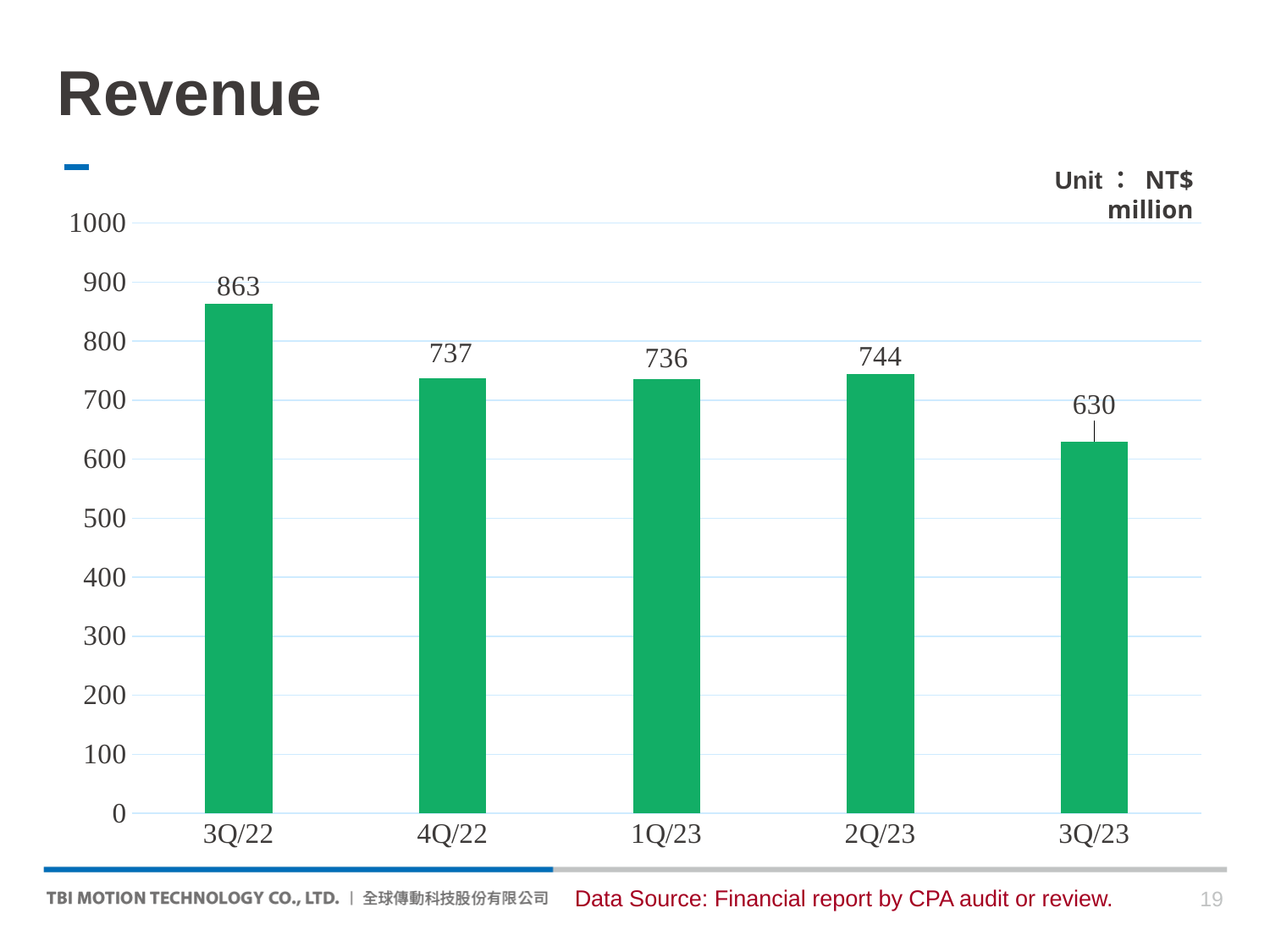
What kind of chart is shown on the slide? bar chart How many quarters are shown on the chart? 5 What is the difference in revenue between 3Q/22 and 3Q/23? 233 Is the revenue for 3Q/23 greater or less than 700? less What is the revenue for 3Q/23? 630 What is the revenue for 3Q/22? 863 What is the difference in revenue between 2Q/23 and 1Q/23? 8 What is the revenue for 4Q/22? 737 What unit is the revenue chart expressed in? NT$ million Which is larger, the revenue for 3Q/22 or the revenue for 2Q/23? 3Q/22 Which quarter has the lowest revenue? 3Q/23 Which quarter has the highest revenue? 3Q/22